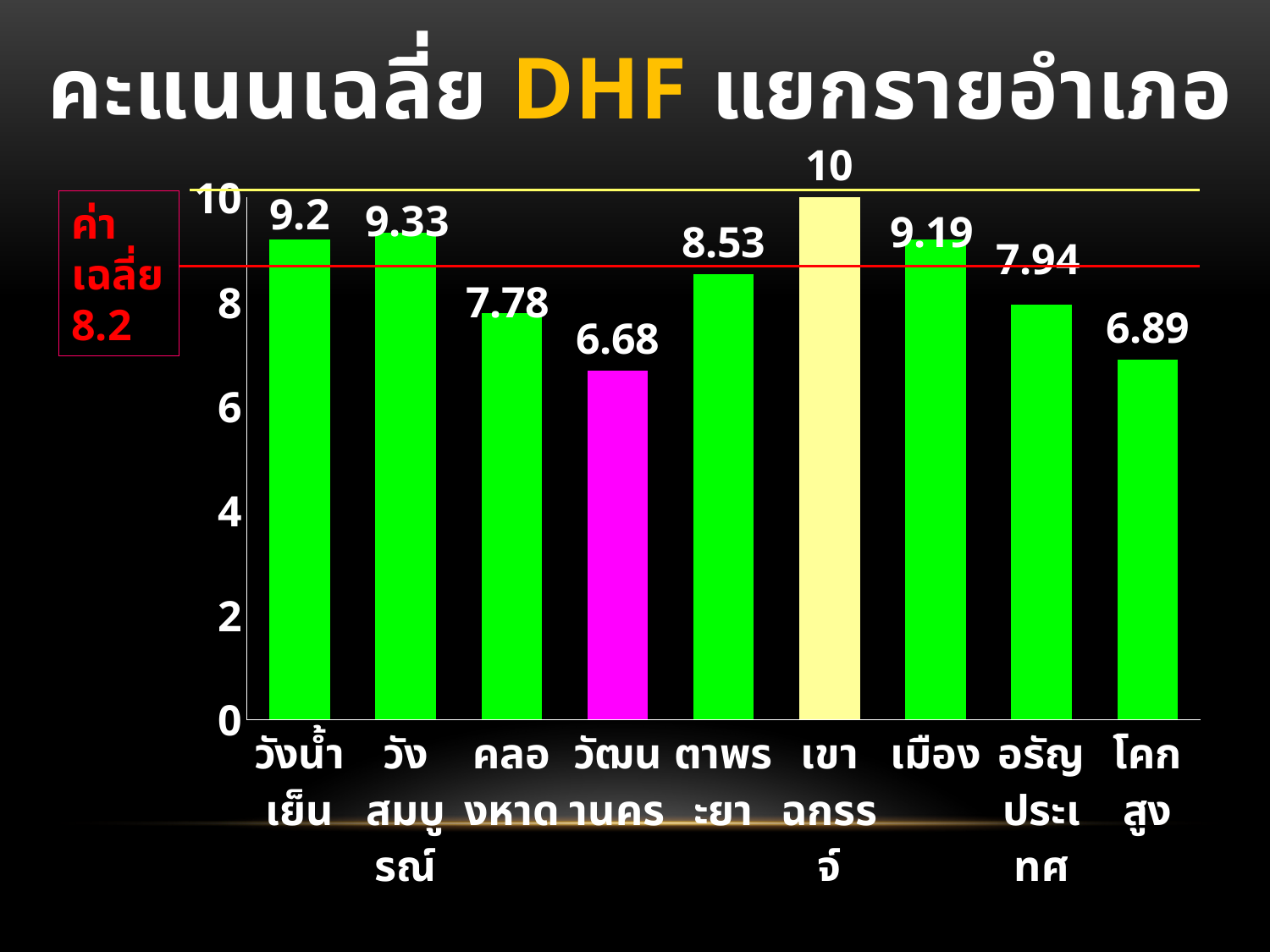
Which district has the lowest average DHF score? วัฒนานคร Which has a higher average DHF score, เมือง or โคกสูง? เมือง What is the difference between the scores of วังสมบูรณ์ and คลองหาด? 1.55 What colour is the bar for เขาฉกรรจ์? yellow What is the average DHF score for ตาพระยา? 8.53 How many districts are shown in the chart? 9 Is the value for คลองหาด greater or less than 8? less What is the average DHF score for อรัญประเทศ? 7.94 What overall average value (ค่าเฉลี่ย) is indicated by the red line on the chart? 8.2 What kind of chart is shown on the slide? bar chart Which district has the highest average DHF score? เขาฉกรรจ์ What is the average DHF score for วัฒนานคร? 6.68